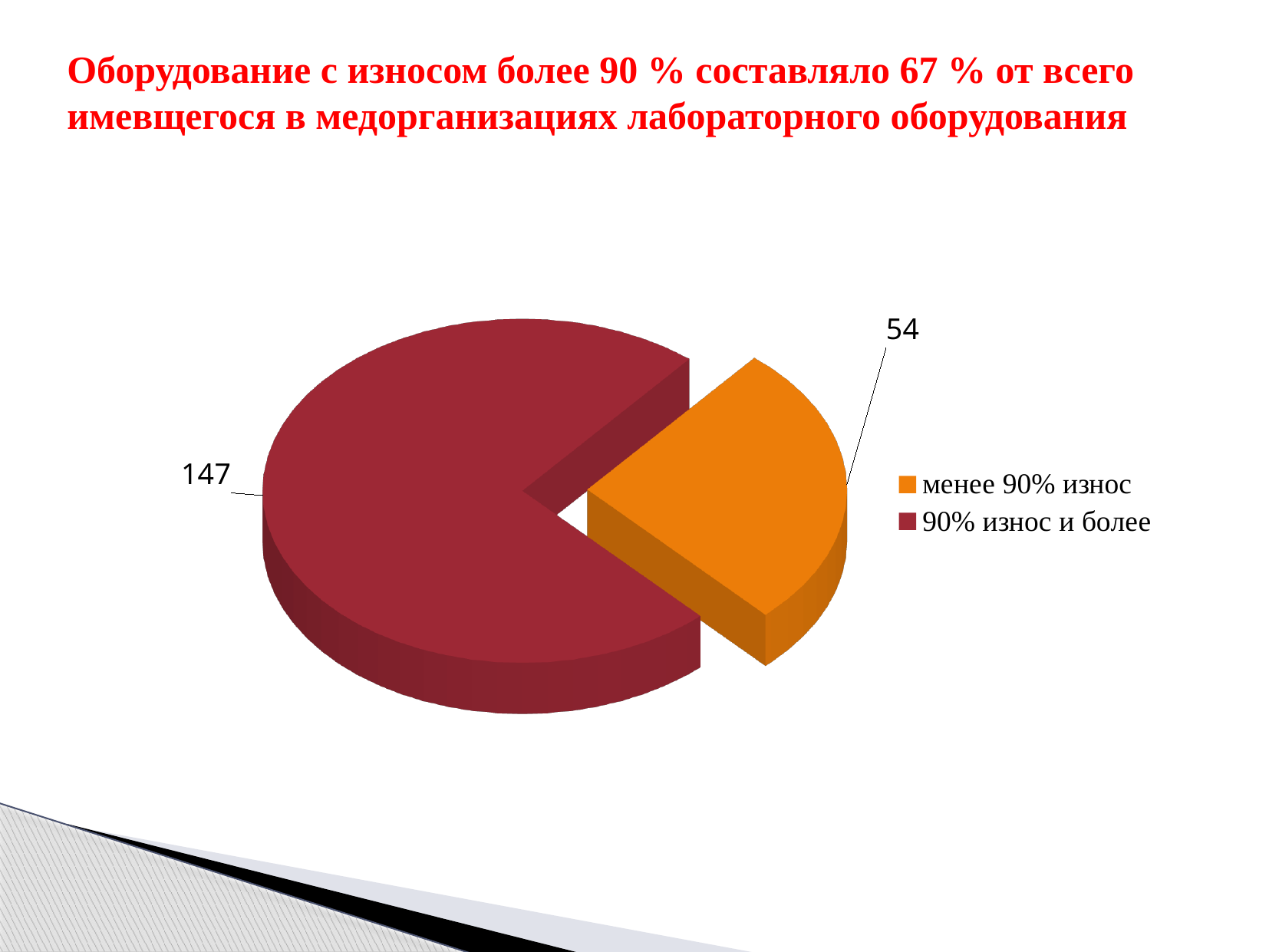
How many entries does the legend list? 2 What is the value for "90% износ и более"? 147 What colour is the slice for "менее 90% износ"? orange What is the value for "менее 90% износ"? 54 Which category has the smallest slice of the pie? менее 90% износ How many slices does the pie chart have? 2 What colour is the slice for "90% износ и более"? dark red Which is larger: the value for "90% износ и более" or the value for "менее 90% износ"? 90% износ и более What is the total of the two values shown on the pie chart? 201 Which category has the largest slice of the pie? 90% износ и более What is the difference between the values for "90% износ и более" and "менее 90% износ"? 93 What kind of chart is shown on the slide? pie chart